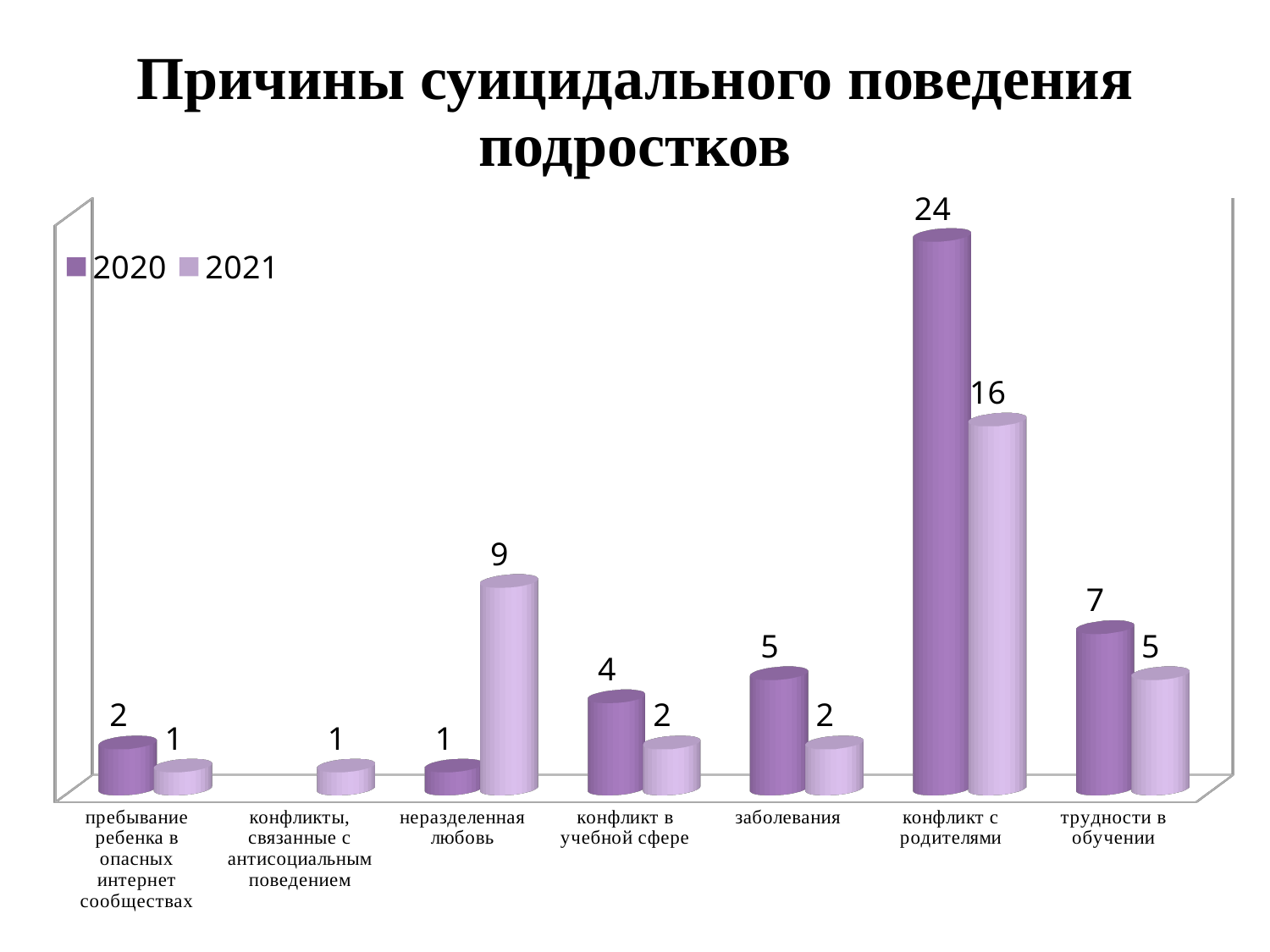
How many series does the legend list? 2 What kind of chart is shown on the slide? bar chart How many categories are shown on the x axis? 7 Which is larger for «неразделенная любовь»: the 2020 value or the 2021 value? 2021 What is the 2021 value for «трудности в обучении»? 5 What are the two series named in the legend? 2020 and 2021 What is the 2020 value for «заболевания»? 5 Which category has the highest 2020 value? конфликт с родителями What is the 2021 value for «неразделенная любовь»? 9 Which category has the highest 2021 value? конфликт с родителями What is the difference between the 2020 and 2021 values for «конфликт с родителями»? 8 What is the 2020 value for «конфликт с родителями»? 24